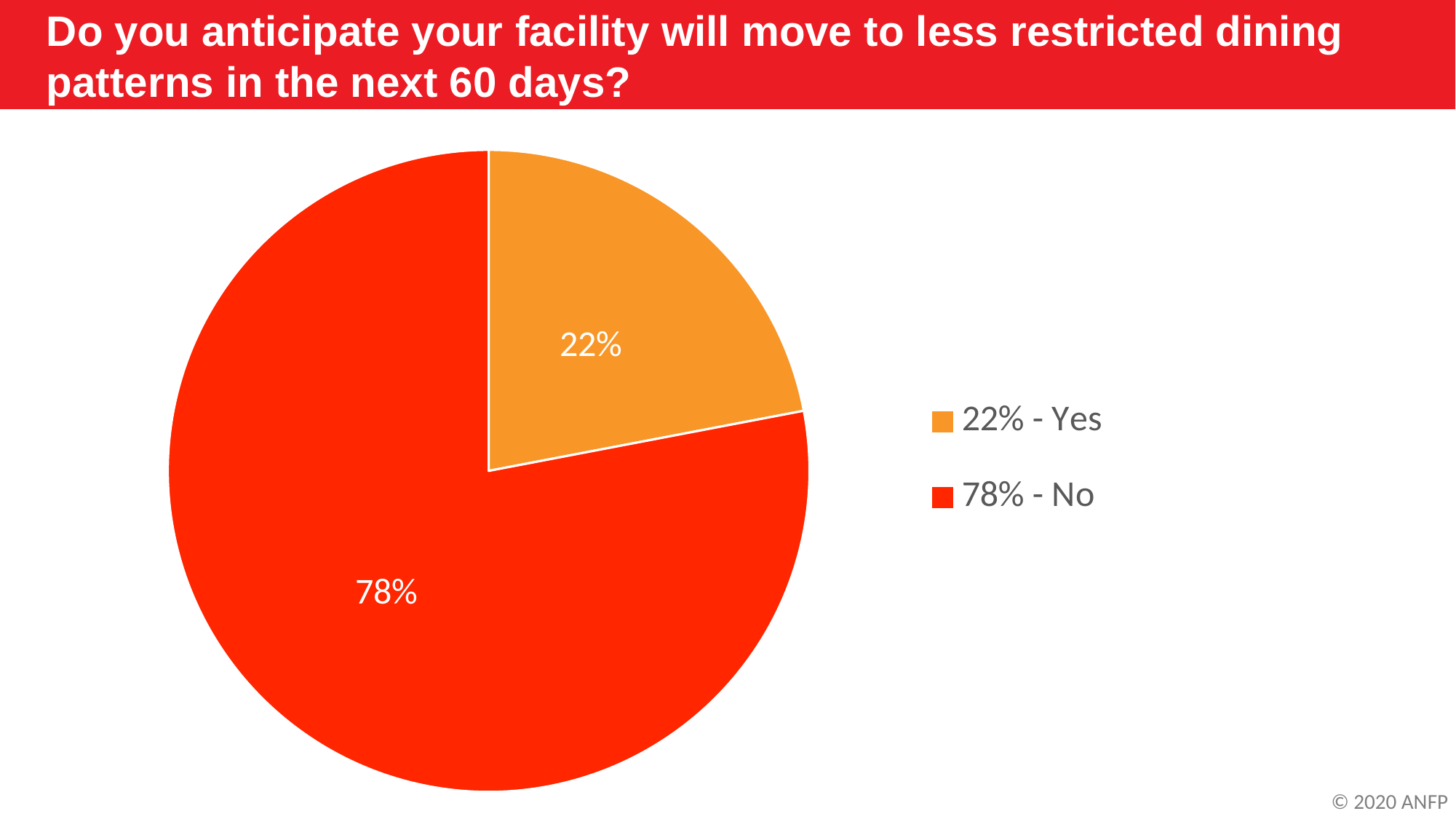
What percentage of respondents answered Yes? 22% How many entries does the legend list? 2 What question does the chart title ask? Do you anticipate your facility will move to less restricted dining patterns in the next 60 days? What kind of chart is shown on the slide? pie chart What percentage of respondents answered No? 78% What is the difference in percentage points between the No and Yes responses? 56 Which response has the smallest share of the pie? Yes Which is larger, the share for Yes or the share for No? No What colour is the slice representing Yes? orange Which response has the largest share of the pie? No What share of the pie does the No slice represent? 78% How many slices does the pie chart have? 2